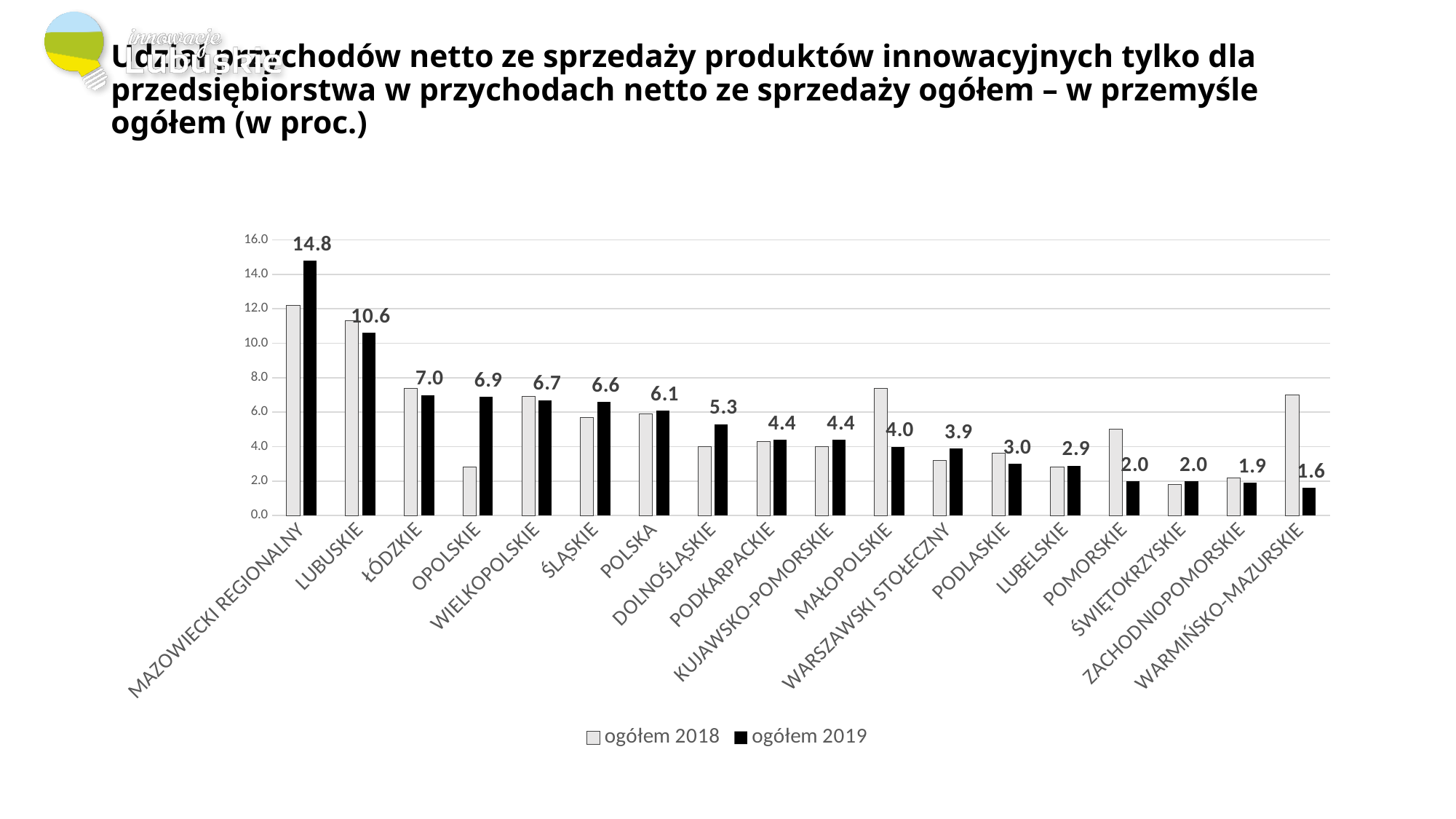
What is the value for POLSKA in the ogółem 2019 series? 6.1 What is the difference between the ogółem 2019 values for MAZOWIECKI REGIONALNY and LUBUSKIE? 4.2 Which category has the highest value in the ogółem 2019 series? MAZOWIECKI REGIONALNY In the ogółem 2019 series, which is larger: POLSKA or DOLNOŚLĄSKIE? POLSKA Is the ogółem 2018 value for OPOLSKIE greater or less than 4.0? less How many categories are shown on the x axis of the chart? 18 Do the ogółem 2019 values generally rise or fall from left to right along the x axis? fall What is the value for LUBUSKIE in the ogółem 2019 series? 10.6 How many series does the legend list? 2 What kind of chart is shown on the slide? bar chart Is the ogółem 2018 value for MAŁOPOLSKIE greater or less than 6.0? greater Which category has the lowest value in the ogółem 2019 series? WARMIŃSKO-MAZURSKIE